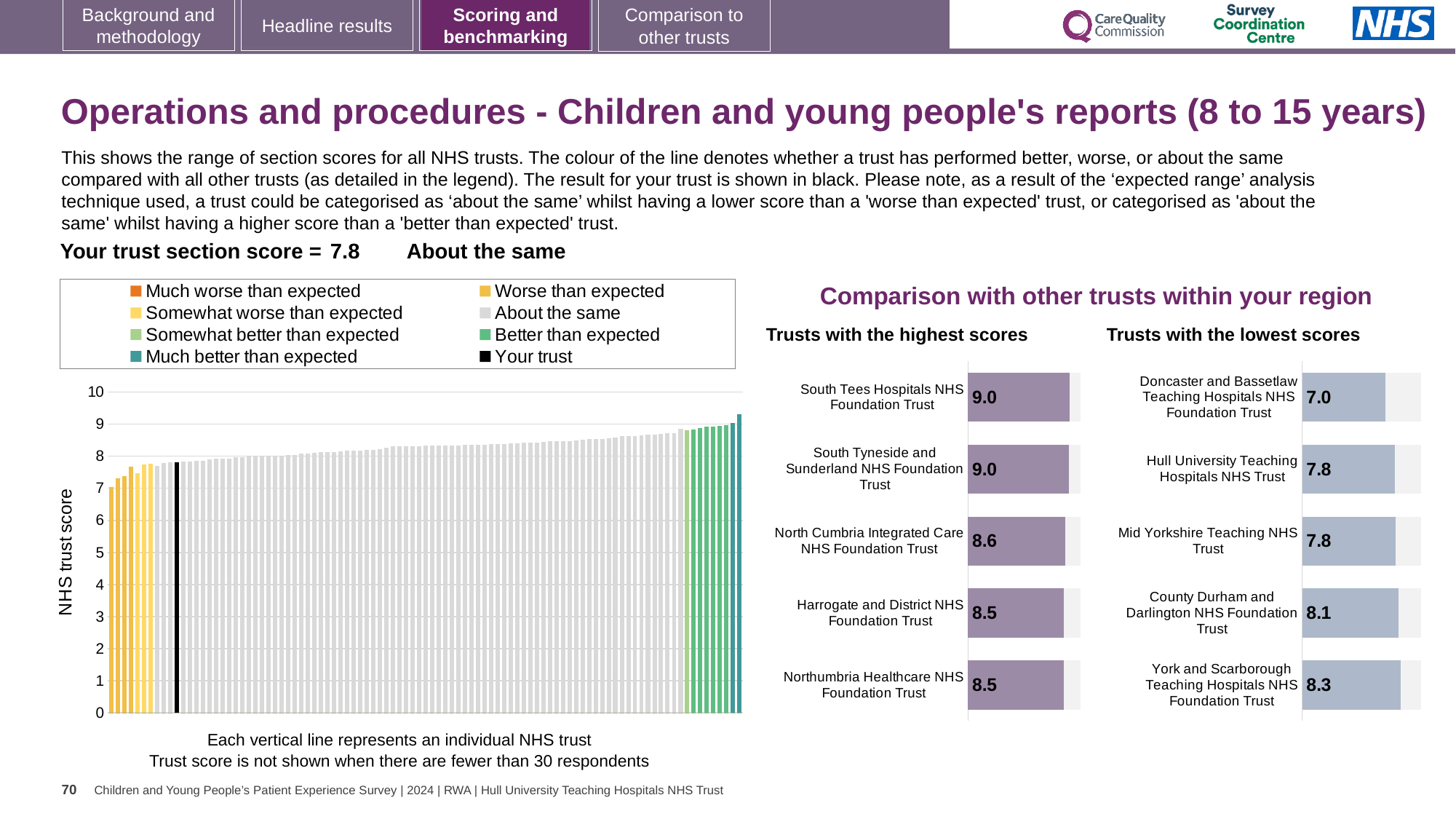
In the 'Trusts with the highest scores' chart, what is the difference between the score for South Tees Hospitals NHS Foundation Trust and the score for North Cumbria Integrated Care NHS Foundation Trust? 0.4 What kind of chart is the large chart on the left showing all NHS trusts? bar chart In the 'Trusts with the lowest scores' chart, which trust has the lowest score? Doncaster and Bassetlaw Teaching Hospitals NHS Foundation Trust How many entries does the legend of the large chart on the left list? 8 In the 'Trusts with the lowest scores' chart, what is the score for Doncaster and Bassetlaw Teaching Hospitals NHS Foundation Trust? 7.0 In the large chart on the left showing all NHS trusts, do the bar values rise or fall from left to right? rise In the 'Trusts with the lowest scores' chart, which trust has the highest score? York and Scarborough Teaching Hospitals NHS Foundation Trust In the 'Trusts with the lowest scores' chart, what is the difference between the score for York and Scarborough Teaching Hospitals NHS Foundation Trust and the score for Doncaster and Bassetlaw Teaching Hospitals NHS Foundation Trust? 1.3 In the 'Trusts with the highest scores' chart, what is the score for North Cumbria Integrated Care NHS Foundation Trust? 8.6 In the 'Trusts with the lowest scores' chart, which has the larger score: County Durham and Darlington NHS Foundation Trust or Hull University Teaching Hospitals NHS Trust? County Durham and Darlington NHS Foundation Trust In the 'Trusts with the highest scores' chart, how many trusts are shown? 5 In the large chart on the left showing all NHS trusts, is the value of the tallest bar greater or less than 9? greater